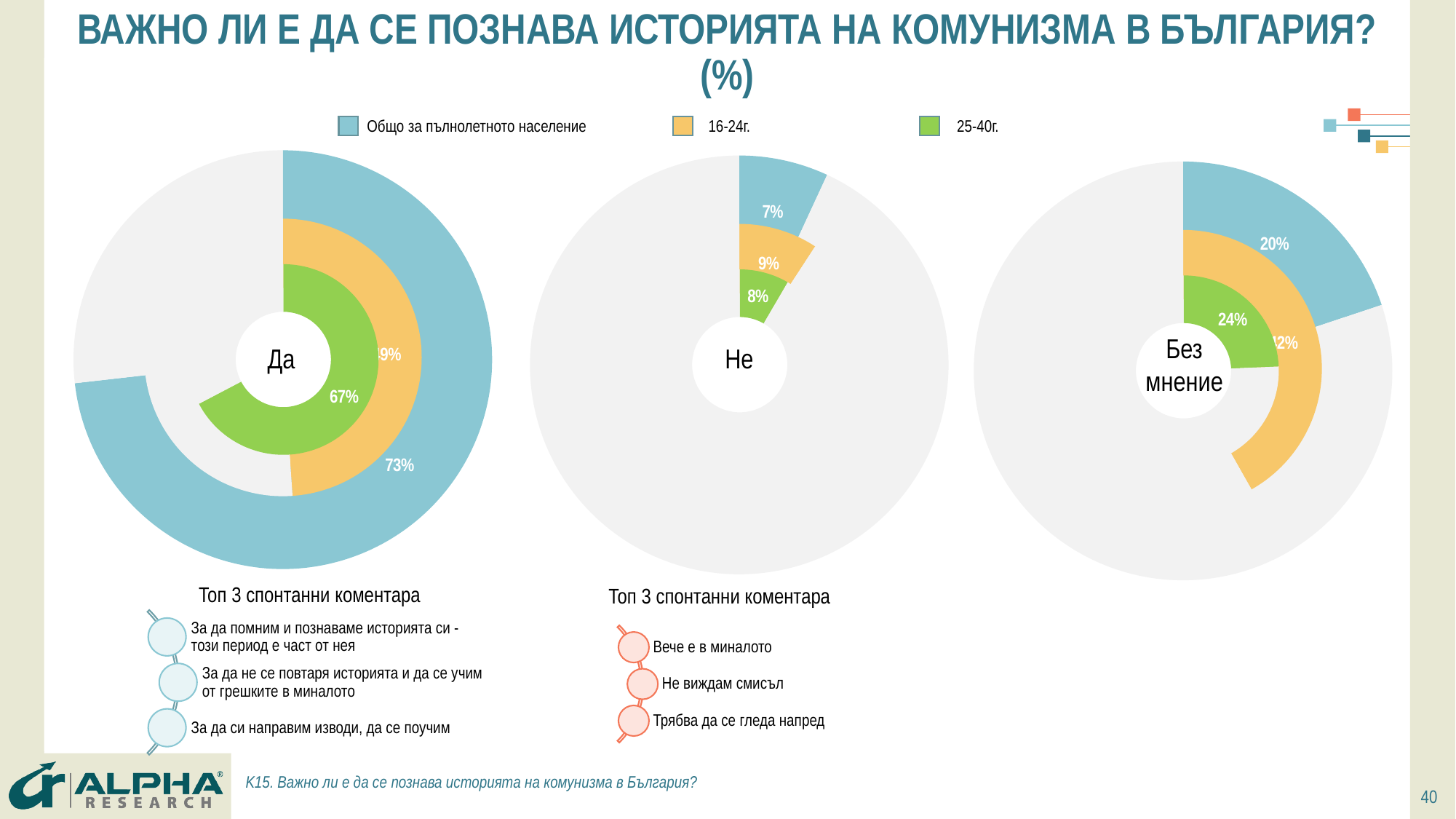
In the "Да" chart, what is the difference between the value for Общо за пълнолетното население and the value for 25-40г.? 6 percentage points In the "Не" chart, what is the value for the 25-40г. group? 8% In the "Не" chart, what is the value for Общо за пълнолетното население? 7% In the "Не" chart, what is the value for the 16-24г. group? 9% How many series does the legend list? 3 In the "Да" chart, what is the value for the 25-40г. group? 67% In the "Без мнение" chart, what is the value for Общо за пълнолетното население? 20% In the "Без мнение" chart, what is the value for the 25-40г. group? 24% In the "Не" chart, which group has the highest value? 16-24г. In the "Без мнение" chart, which is larger: the value for Общо за пълнолетното население or the value for 25-40г.? 25-40г. In the "Да" chart, what is the value for Общо за пълнолетното население? 73% What kind of chart is the "Да" chart? Donut (pie) chart